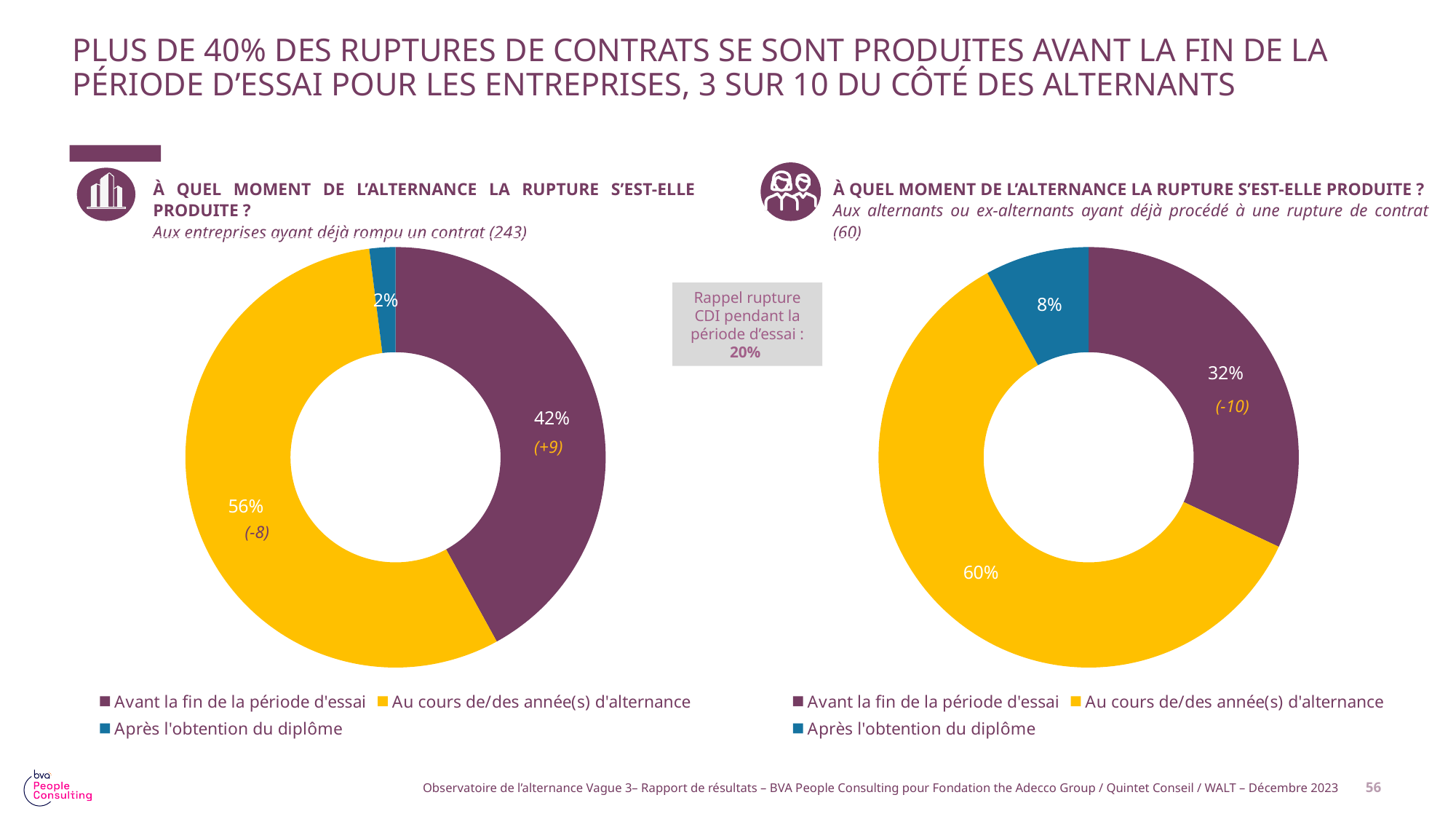
What type of chart is used on the left side of the slide? Doughnut (pie) chart In the left chart (entreprises), which category has the smallest share? Après l'obtention du diplôme In the left chart (entreprises), what share of ruptures occurred 'Au cours de/des année(s) d'alternance'? 56% In the left chart (entreprises), what share of ruptures occurred 'Après l'obtention du diplôme'? 2% In the right chart (alternants), which category has the largest share? Au cours de/des année(s) d'alternance In the right chart (alternants), what share of ruptures occurred 'Après l'obtention du diplôme'? 8% How many categories does the legend of the right chart (alternants) list? 3 What colour represents 'Après l'obtention du diplôme' in both charts? Blue In the left chart (entreprises), what is the difference between the 'Au cours de/des année(s) d'alternance' share and the 'Avant la fin de la période d'essai' share? 14 percentage points In the left chart (entreprises), what share of ruptures occurred 'Avant la fin de la période d'essai'? 42% In the right chart (alternants), what share of ruptures occurred 'Avant la fin de la période d'essai'? 32% Which chart shows a larger share for 'Avant la fin de la période d'essai', the left (entreprises) or the right (alternants)? Left (entreprises)